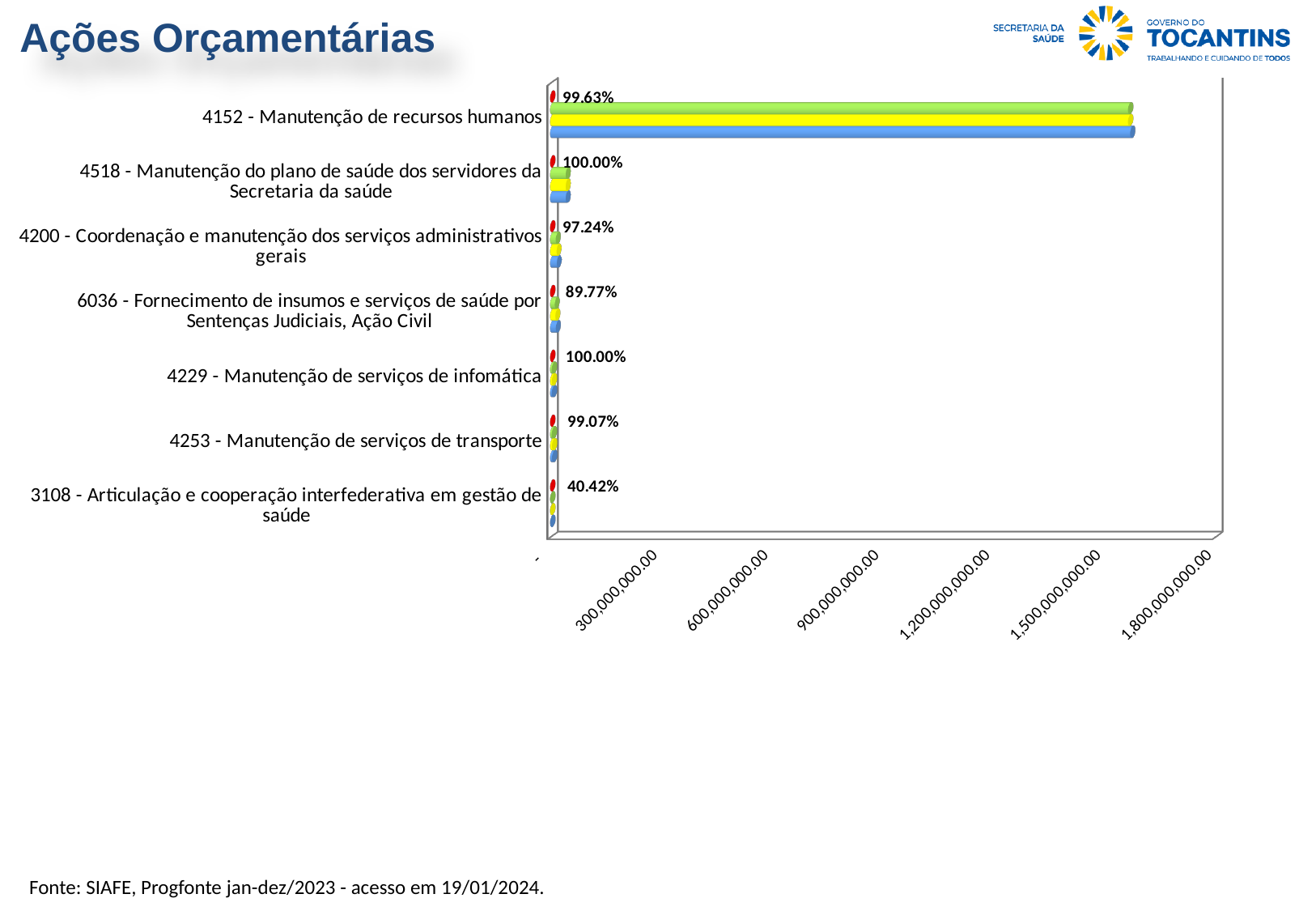
What kind of chart is shown on the slide? Bar chart What is the difference between the percentage labels for "4229 - Manutenção de serviços de infomática" and "3108 - Articulação e cooperação interfederativa em gestão de saúde"? 59.58% What percentage label is shown for "3108 - Articulação e cooperação interfederativa em gestão de saúde"? 40.42% Is the value of the longest bar for "4152 - Manutenção de recursos humanos" greater or less than 1,500,000,000.00? greater Which category has the lowest percentage label? 3108 - Articulação e cooperação interfederativa em gestão de saúde What percentage label is shown for "6036 - Fornecimento de insumos e serviços de saúde por Sentenças Judiciais, Ação Civil"? 89.77% Is the value of the longest bar for "4518 - Manutenção do plano de saúde dos servidores da Secretaria da saúde" greater or less than 300,000,000.00? less What percentage label is shown for "4152 - Manutenção de recursos humanos"? 99.63% How many categories (budget actions) are listed on the chart? 7 What percentage label is shown for "4253 - Manutenção de serviços de transporte"? 99.07% What percentage label is shown for "4200 - Coordenação e manutenção dos serviços administrativos gerais"? 97.24% What is the title of the slide containing the chart? Ações Orçamentárias